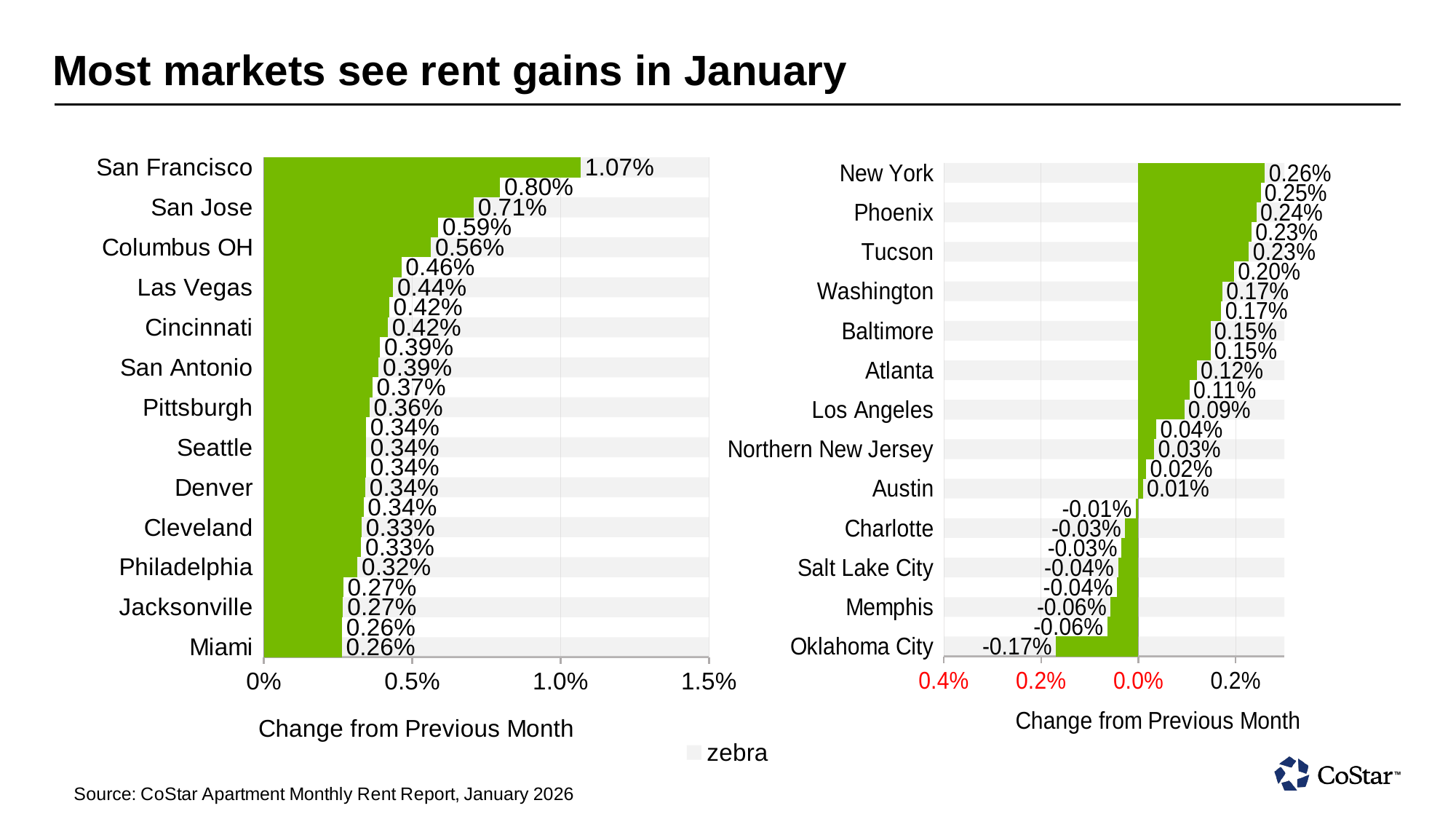
On the right chart, which market has the lowest change from previous month? Oklahoma City On the right chart, what is the value for Los Angeles? 0.09% How many bars are plotted on the right chart? 25 On the left chart, is the value for Las Vegas greater or less than 0.5%? less On the left chart, what is the difference between San Francisco's value and San Jose's value? 0.36% What type of chart is used on the left side of the slide? Bar chart On the right chart, what is the change from previous month for Oklahoma City? -0.17% On the left chart, which labeled market has the highest change from previous month? San Francisco On the left chart, what is the value for Columbus OH? 0.56% On the left chart, what is the change from previous month for San Francisco? 1.07% What is the x-axis title of the right chart? Change from Previous Month On the right chart, which is larger, the value for New York or the value for Atlanta? New York